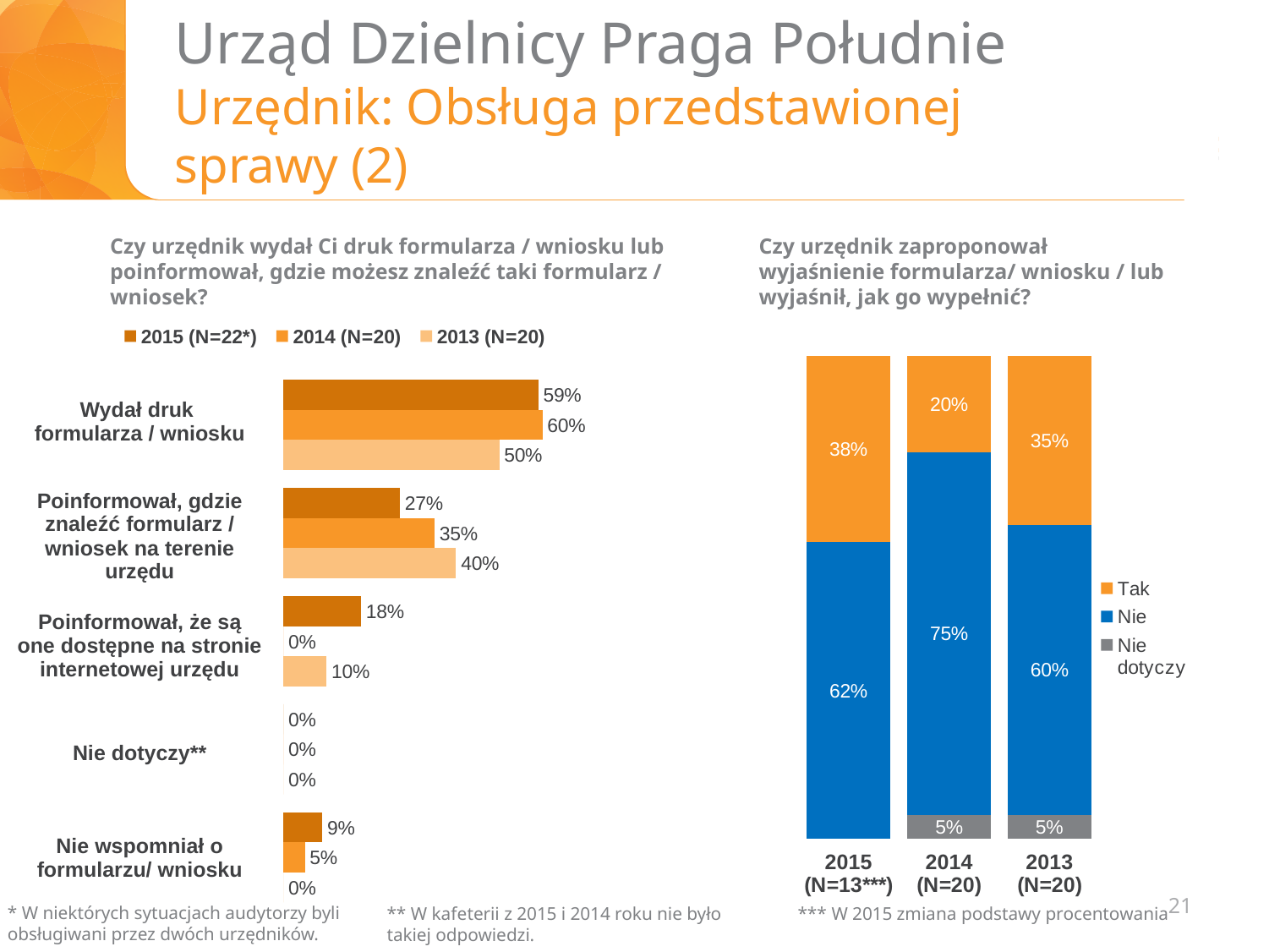
In the left chart, what is the difference between the 2014 and 2015 values for 'Poinformował, gdzie znaleźć formularz / wniosek na terenie urzędu'? 8% What type of chart is the right chart? Stacked bar chart In the left chart, what is the 2013 value for 'Poinformował, gdzie znaleźć formularz / wniosek na terenie urzędu'? 40% How many categories are shown in the left chart? 5 In the right chart, what is the difference between the 'Tak' values for 2013 (N=20) and 2014 (N=20)? 15% In the left chart, what is the 2015 value for 'Wydał druk formularza / wniosku'? 59% How many series does the legend of the left chart list? 3 In the right chart, what is the 'Nie' value for 2014 (N=20)? 75% In the left chart, what is the 2014 value for 'Poinformował, że są one dostępne na stronie internetowej urzędu'? 0% In the left chart, which category has the highest 2014 value? Wydał druk formularza / wniosku In the left chart, which is larger for 'Nie wspomniał o formularzu/ wniosku': the 2015 value or the 2014 value? 2015 In the right chart, what is the 'Tak' value for 2015 (N=13***)? 38%